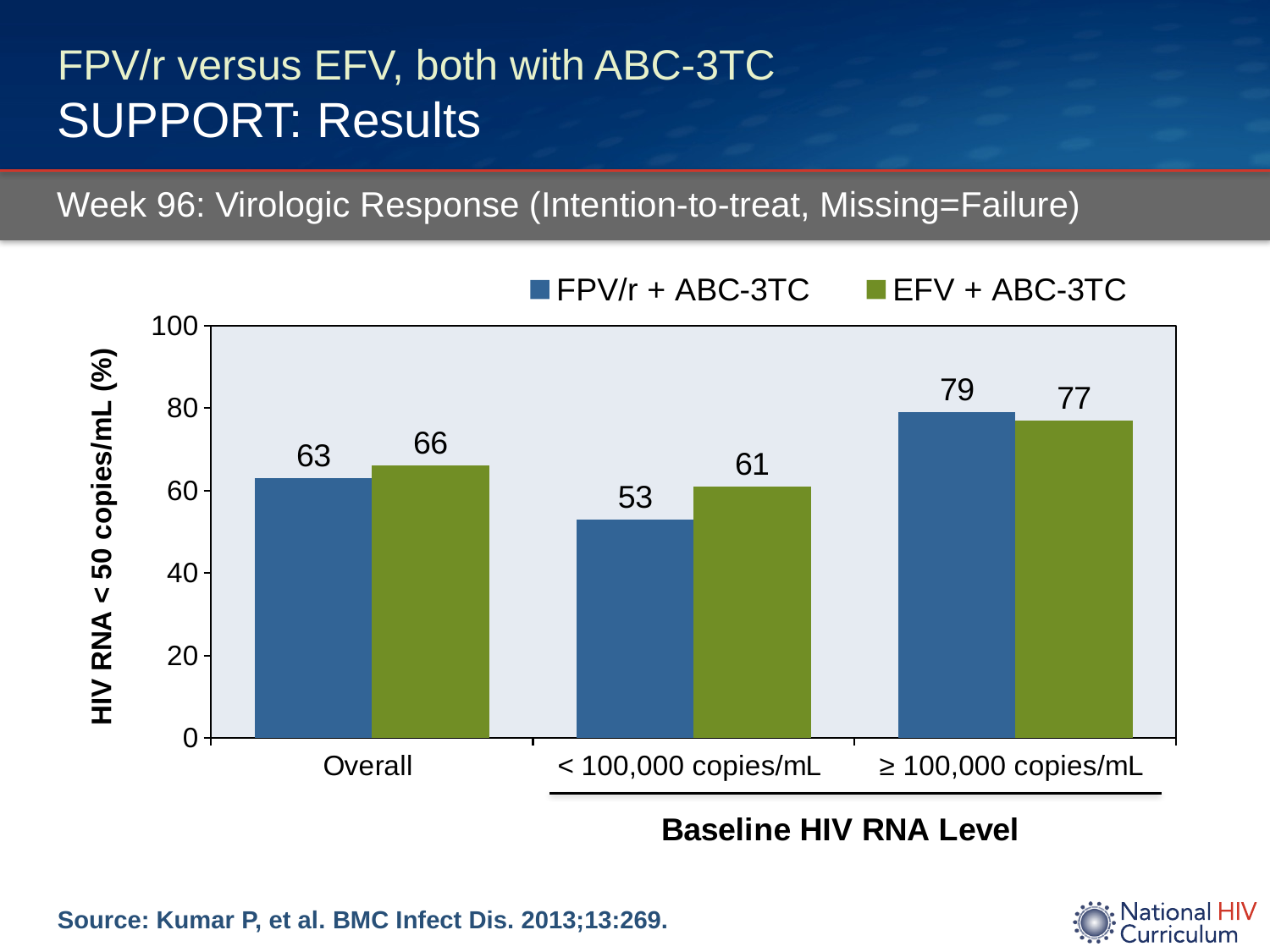
What is the difference between the EFV + ABC-3TC and FPV/r + ABC-3TC values in the < 100,000 copies/mL category? 8 What is the y-axis label of the chart? HIV RNA < 50 copies/mL (%) How many series does the legend list? 2 What is the value for FPV/r + ABC-3TC in the Overall category? 63 What is the value for EFV + ABC-3TC in the < 100,000 copies/mL category? 61 Is the value for FPV/r + ABC-3TC in the < 100,000 copies/mL category greater or less than 60? less Which category has the lowest value for FPV/r + ABC-3TC? < 100,000 copies/mL Which category has the highest value for EFV + ABC-3TC? ≥ 100,000 copies/mL How many categories are shown on the x axis? 3 In the Overall category, which series has the larger value, FPV/r + ABC-3TC or EFV + ABC-3TC? EFV + ABC-3TC What kind of chart is shown on the slide? Bar chart What is the value for FPV/r + ABC-3TC in the ≥ 100,000 copies/mL category? 79